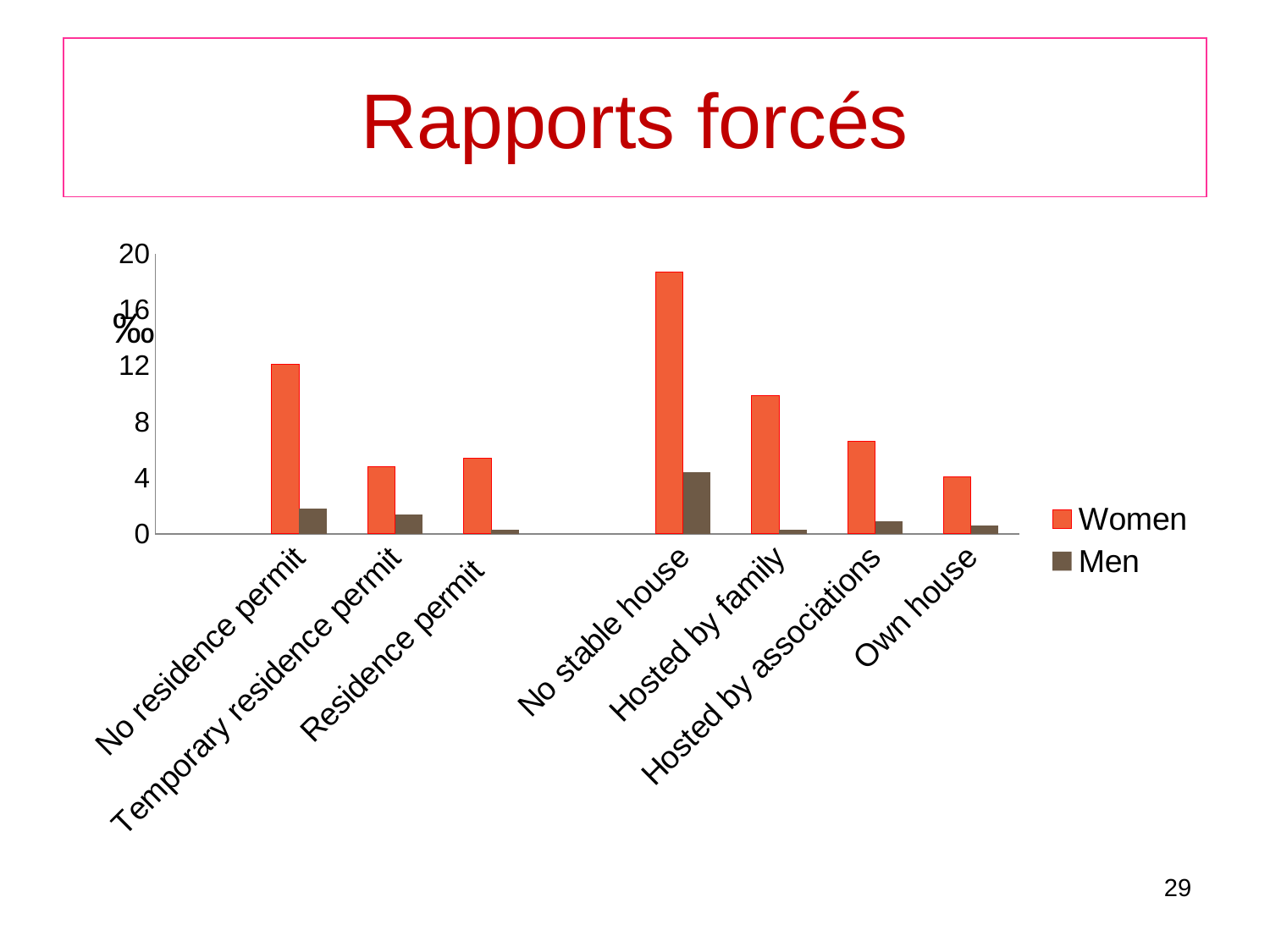
Which category has the highest value for Women? No stable house What kind of chart is shown on the slide? bar chart Is the Men value for No stable house greater or less than 8? less Which category has the highest value for Men? No stable house For Women, which is larger: No residence permit or Hosted by family? No residence permit For No stable house, which series has the larger value, Women or Men? Women Is the Women value for Hosted by family greater or less than 12? less What is the title of the slide containing the chart? Rapports forcés How many series does the legend list? 2 Is the Women value for Hosted by family greater or less than 8? greater How many categories are shown on the x axis? 7